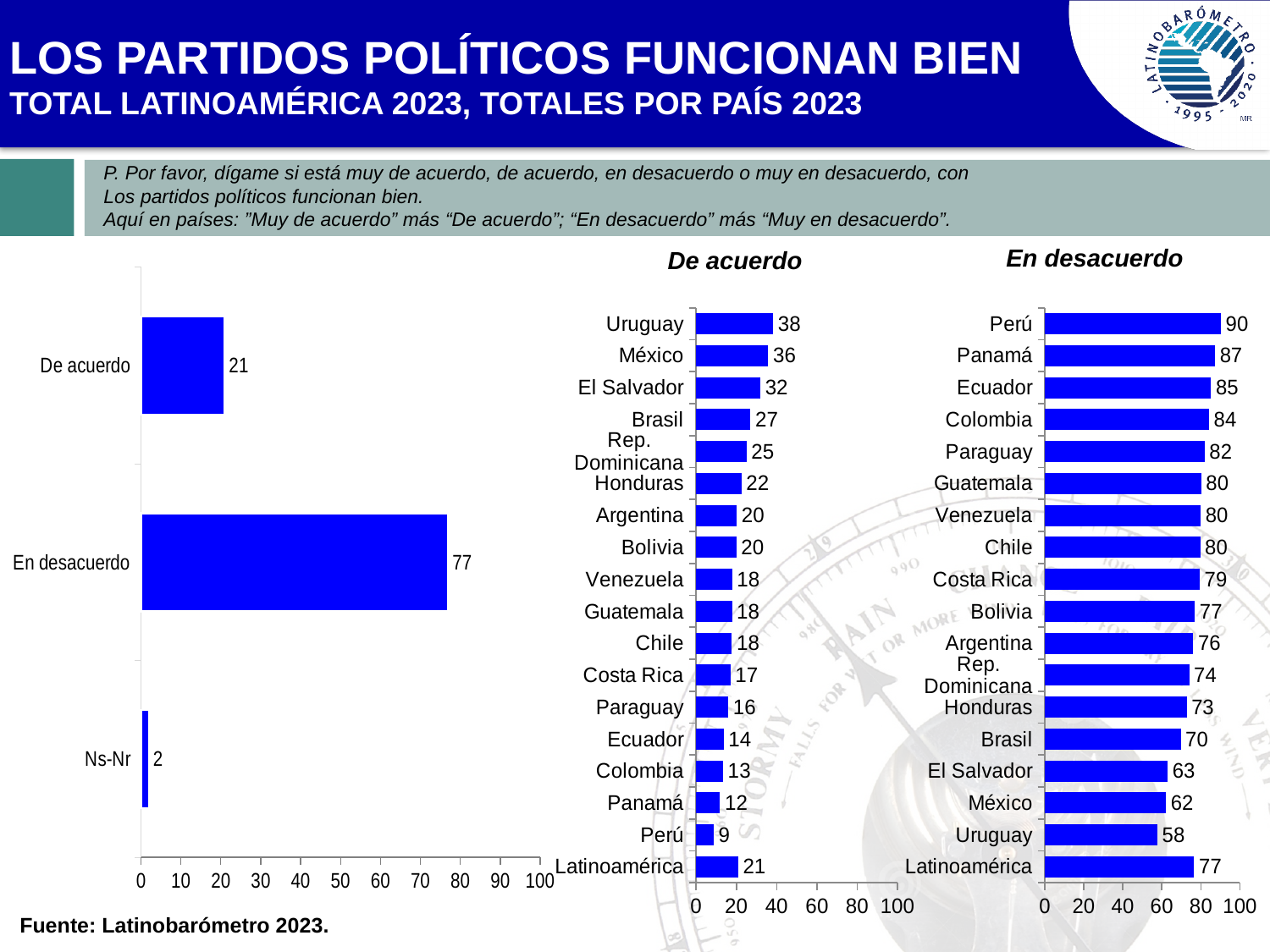
How many countries (excluding Latinoamérica) are listed in the 'En desacuerdo' chart? 17 In the 'En desacuerdo' chart, which country has the lowest value? Uruguay What type of chart is the 'De acuerdo' chart? Bar chart In the 'De acuerdo' chart, which country has the highest value? Uruguay In the left chart (Total Latinoamérica), what is the difference between 'En desacuerdo' and 'De acuerdo'? 56 In the 'En desacuerdo' chart, what is the value for Perú? 90 In the left chart (Total Latinoamérica), what is the value for 'Ns-Nr'? 2 In the 'De acuerdo' chart, what is the value for El Salvador? 32 In the left chart (Total Latinoamérica), what is the value for 'En desacuerdo'? 77 In the 'En desacuerdo' chart, what is the difference between Panamá and México? 25 In the 'De acuerdo' chart, which country has the lowest value? Perú In the 'De acuerdo' chart, which is larger, the value for Brasil or the value for Honduras? Brasil